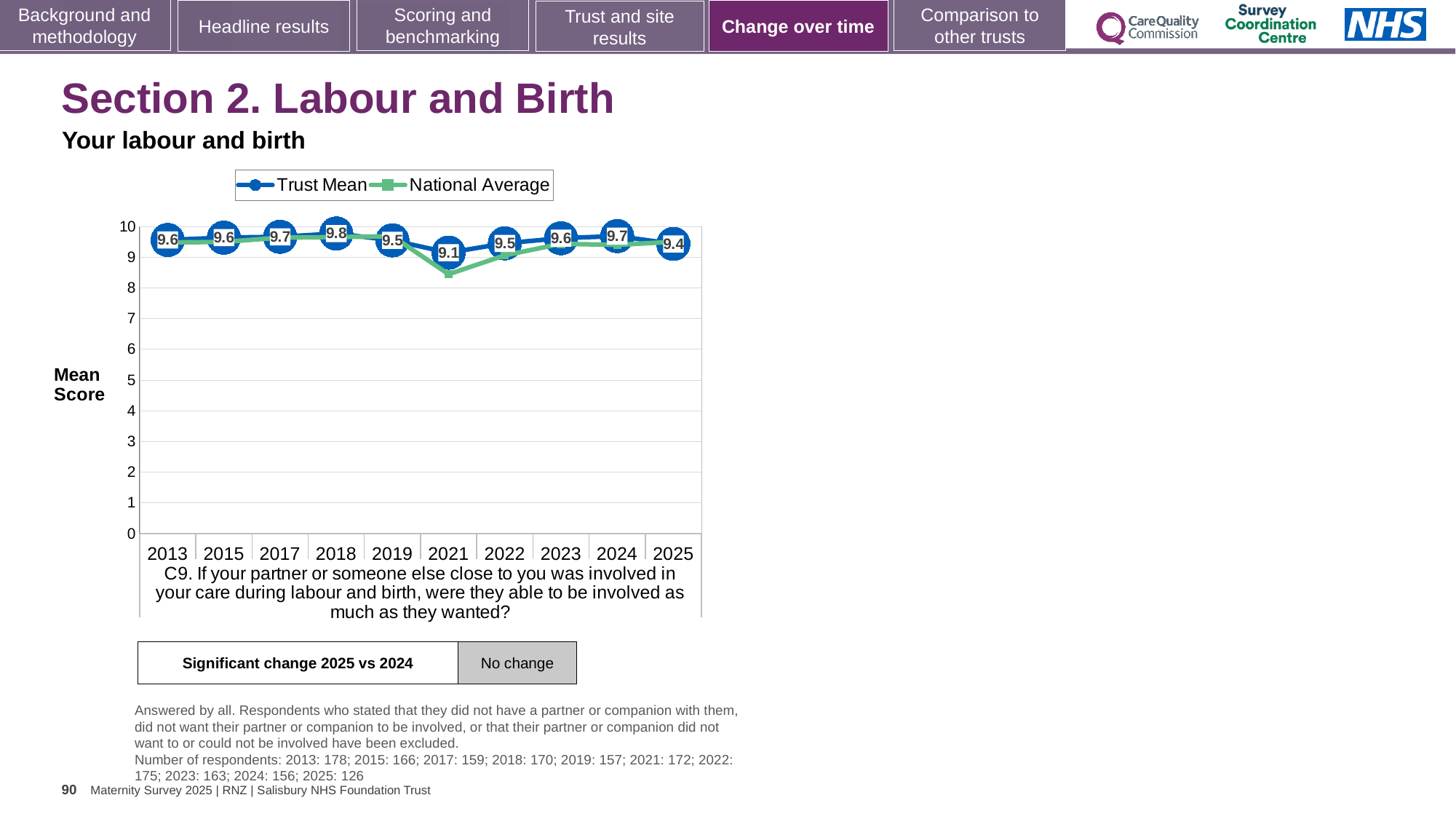
In which year is the Trust Mean highest? 2018 What kind of chart is shown on the slide? line chart In which year is the Trust Mean lowest? 2021 What is the label on the y axis of the chart? Mean Score What is the Trust Mean value for 2025? 9.4 What is the Trust Mean value for 2018? 9.8 What is the Trust Mean value for 2021? 9.1 What is the difference between the Trust Mean in 2018 and in 2021? 0.7 Which year has the larger Trust Mean, 2024 or 2025? 2024 Is the National Average value for 2021 greater or less than 9? less How many series does the legend list? 2 How many years are shown on the x axis? 10